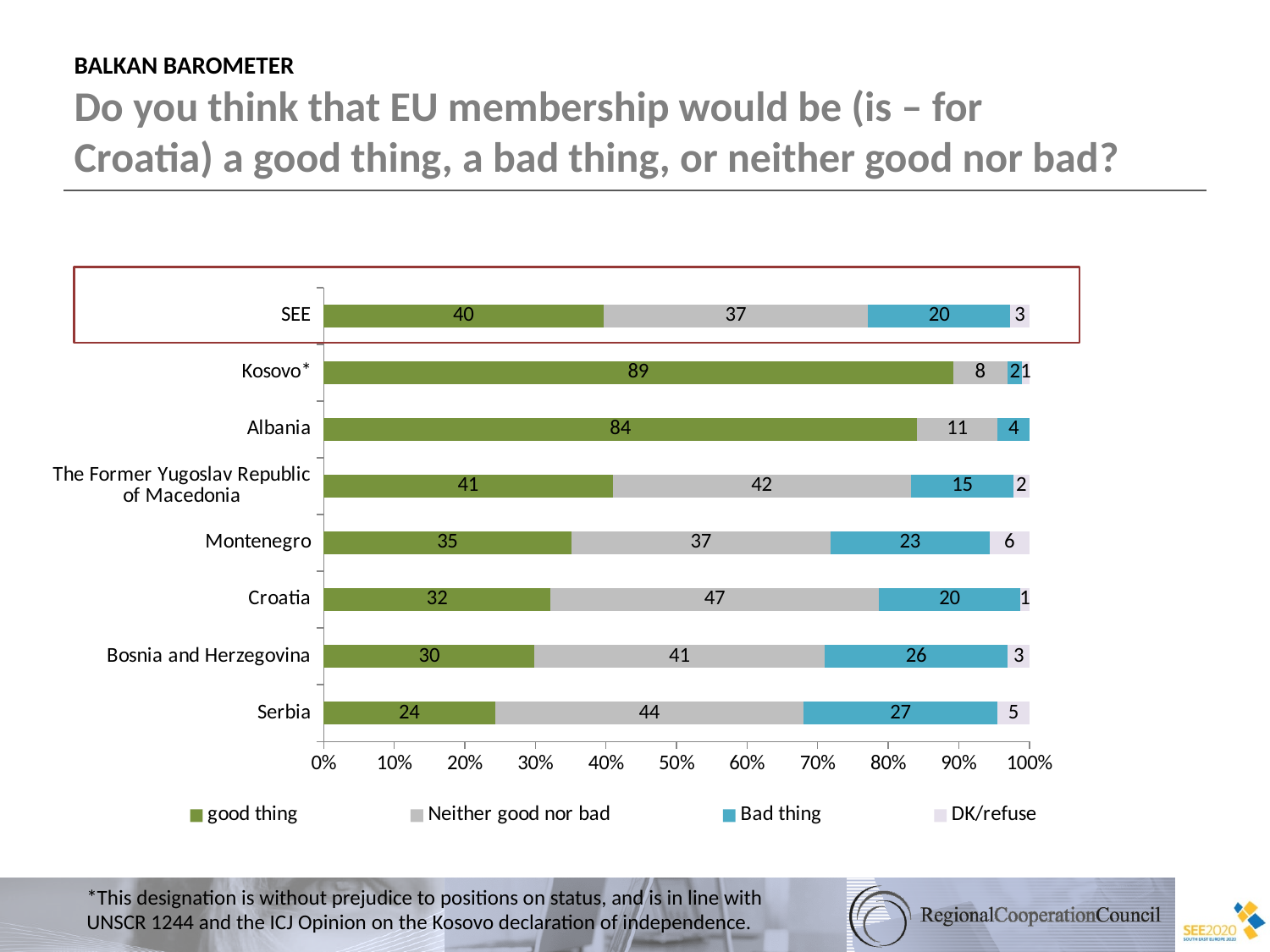
How many categories are shown on the chart? 8 Which category has the highest value for "good thing"? Kosovo* Which category has the lowest value for "good thing"? Serbia What is the value for "DK/refuse" for Montenegro? 6 What is the difference between the "good thing" values for Kosovo* and Albania? 5 What is the value for "good thing" for Kosovo*? 89 Which has the larger "Bad thing" value, Montenegro or Bosnia and Herzegovina? Bosnia and Herzegovina How many series does the legend list? 4 What is the value for "Neither good nor bad" for Croatia? 47 What kind of chart is shown on the slide? Stacked bar chart What is the value for "Bad thing" for Serbia? 27 What colour represents "good thing" in the legend? Green